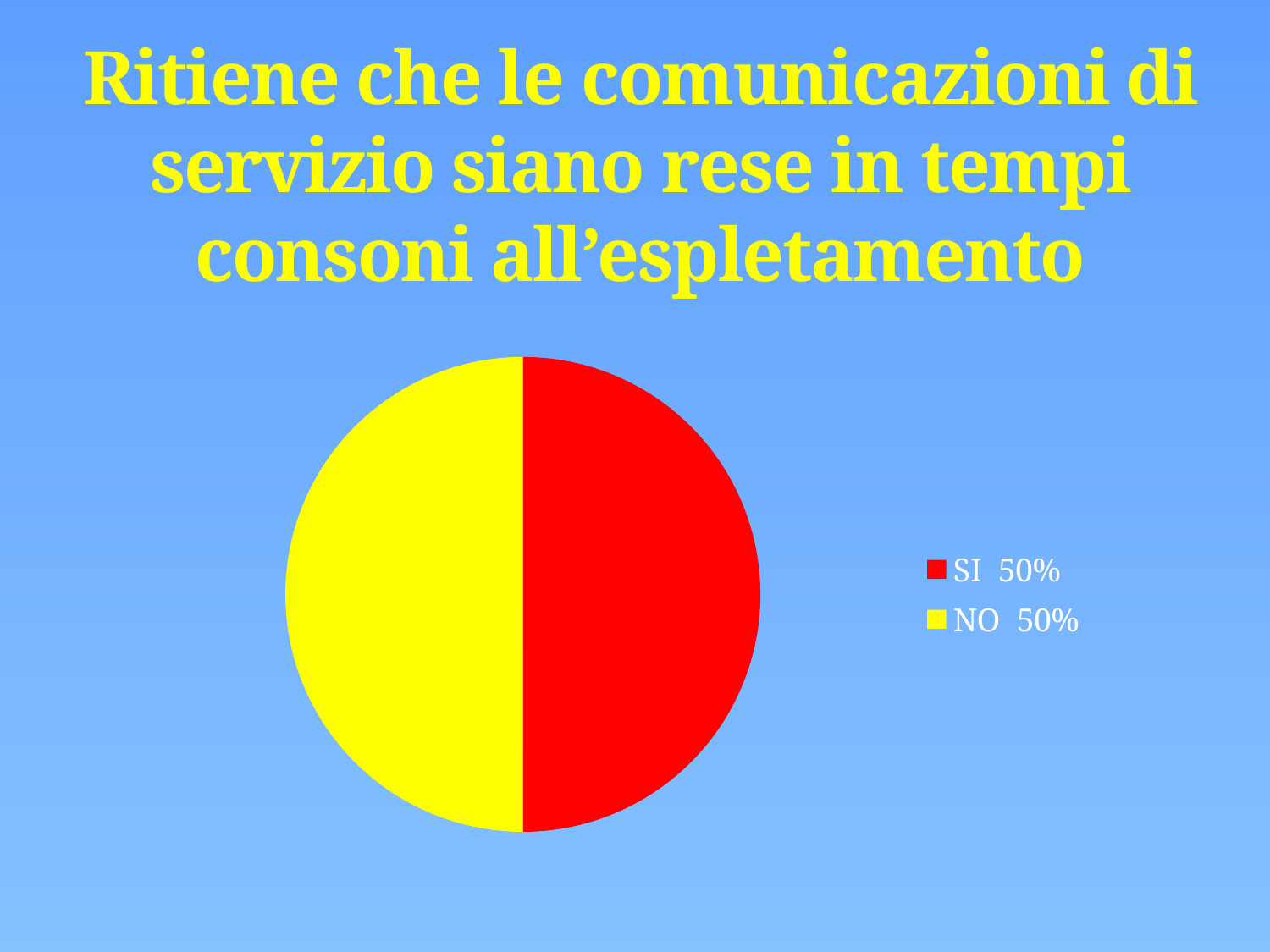
What share of the pie does SI represent? 50% How many slices does the pie chart have? 2 How many entries does the legend list? 2 What share of the pie does NO represent? 50% What colour is the SI slice? red Is the share for SI greater or less than 40%? greater What kind of chart is shown on the slide? pie chart What is the difference between the SI share and the NO share? 0% What colour is the NO slice? yellow What is the total of the SI and NO shares? 100%